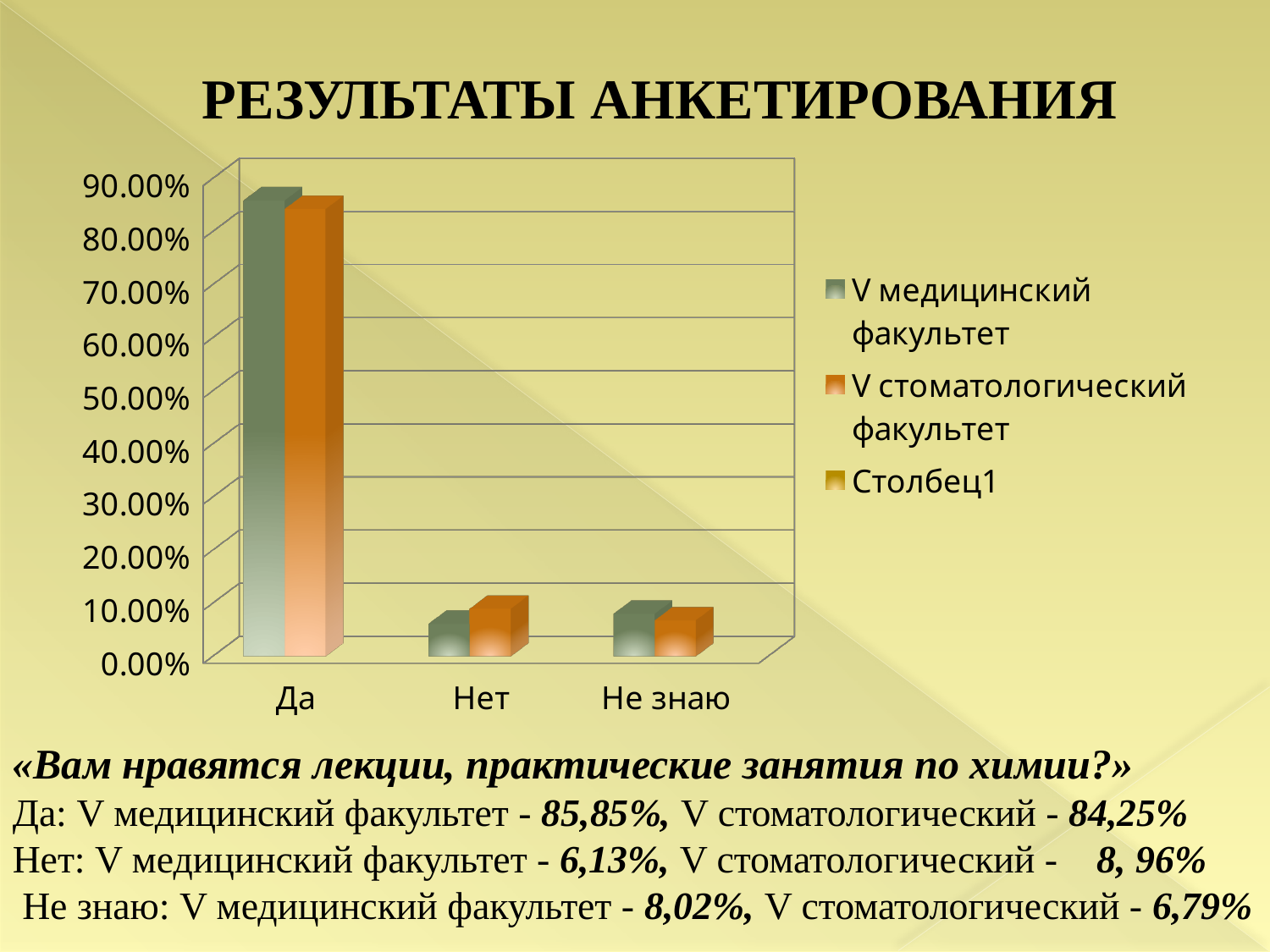
Which category has the lowest value for V стоматологический факультет? Не знаю What is the value for V медицинский факультет in the Нет category? 6,13% Which category has the highest value for V медицинский факультет? Да In the Нет category, which series has the larger value: V медицинский факультет or V стоматологический факультет? V стоматологический факультет Is the value for V медицинский факультет in the Да category greater or less than 80.00%? greater What is the difference between the V медицинский факультет and V стоматологический факультет values in the Нет category? 2,83% How many categories are shown on the x axis of the chart? 3 What is the value for V стоматологический факультет in the Да category? 84,25% What is the value for V стоматологический факультет in the Не знаю category? 6,79% What kind of chart is shown on the slide? Bar chart How many series does the chart legend list? 3 What is the value for V медицинский факультет in the Да category? 85,85%